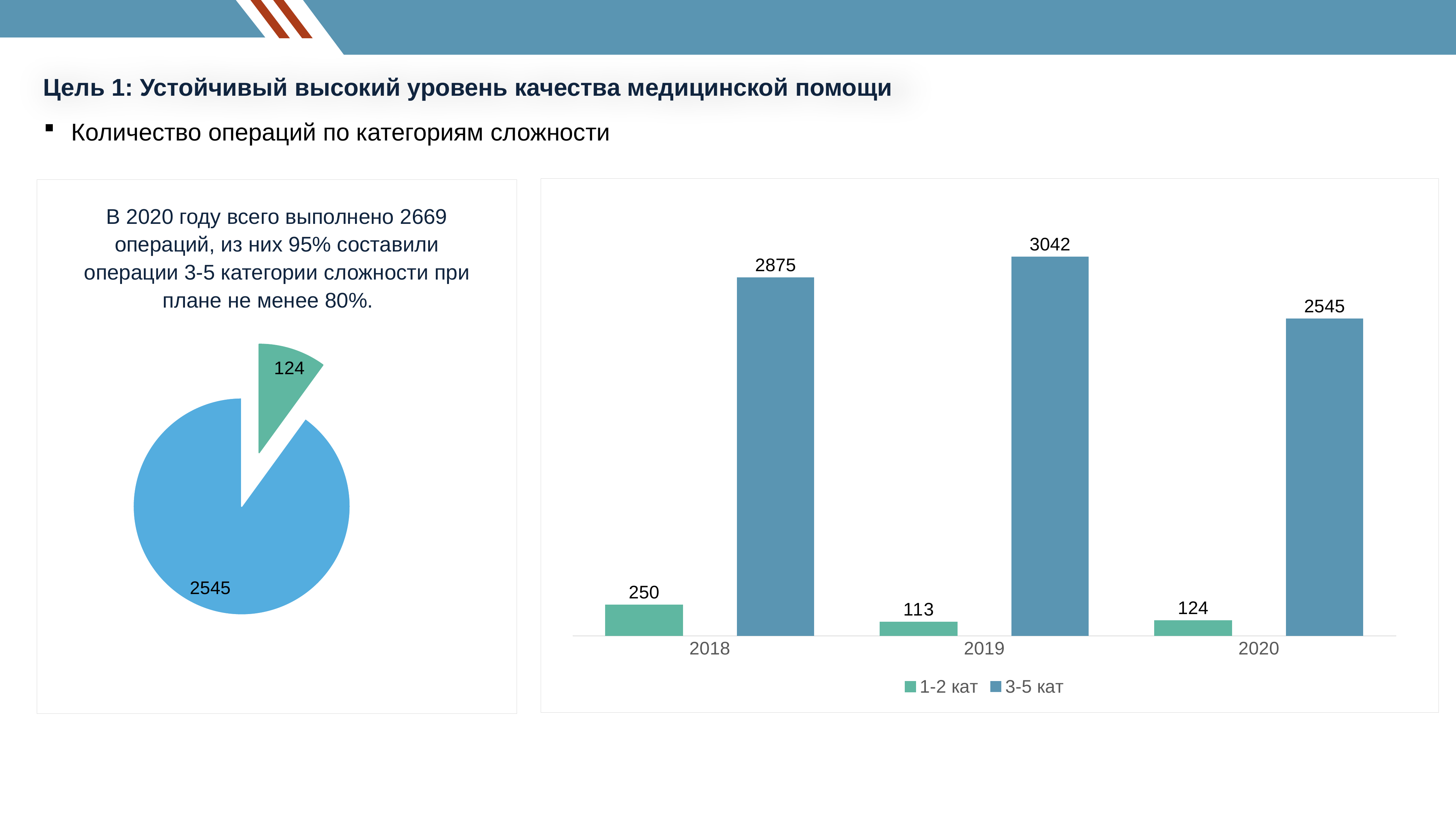
How many years are shown on the x axis of the bar chart on the right? 3 In the bar chart on the right, what is the value for 1-2 кат in 2018? 250 In the bar chart on the right, do the 3-5 кат values rise or fall from 2019 to 2020? Fall In the bar chart on the right, which is larger: the 3-5 кат value for 2018 or for 2020? 2018 In the bar chart on the right, which year has the lowest value for 1-2 кат? 2019 What kind of chart is shown on the left side of the slide? Pie chart In the bar chart on the right, what is the value for 3-5 кат in 2019? 3042 How many series does the legend of the bar chart on the right list? 2 In the bar chart on the right, which year has the highest value for 3-5 кат? 2019 In the pie chart on the left, what is the total of the two slices? 2669 In the bar chart on the right, what is the value for 1-2 кат in 2020? 124 In the bar chart on the right, what is the difference between the 3-5 кат values for 2019 and 2020? 497